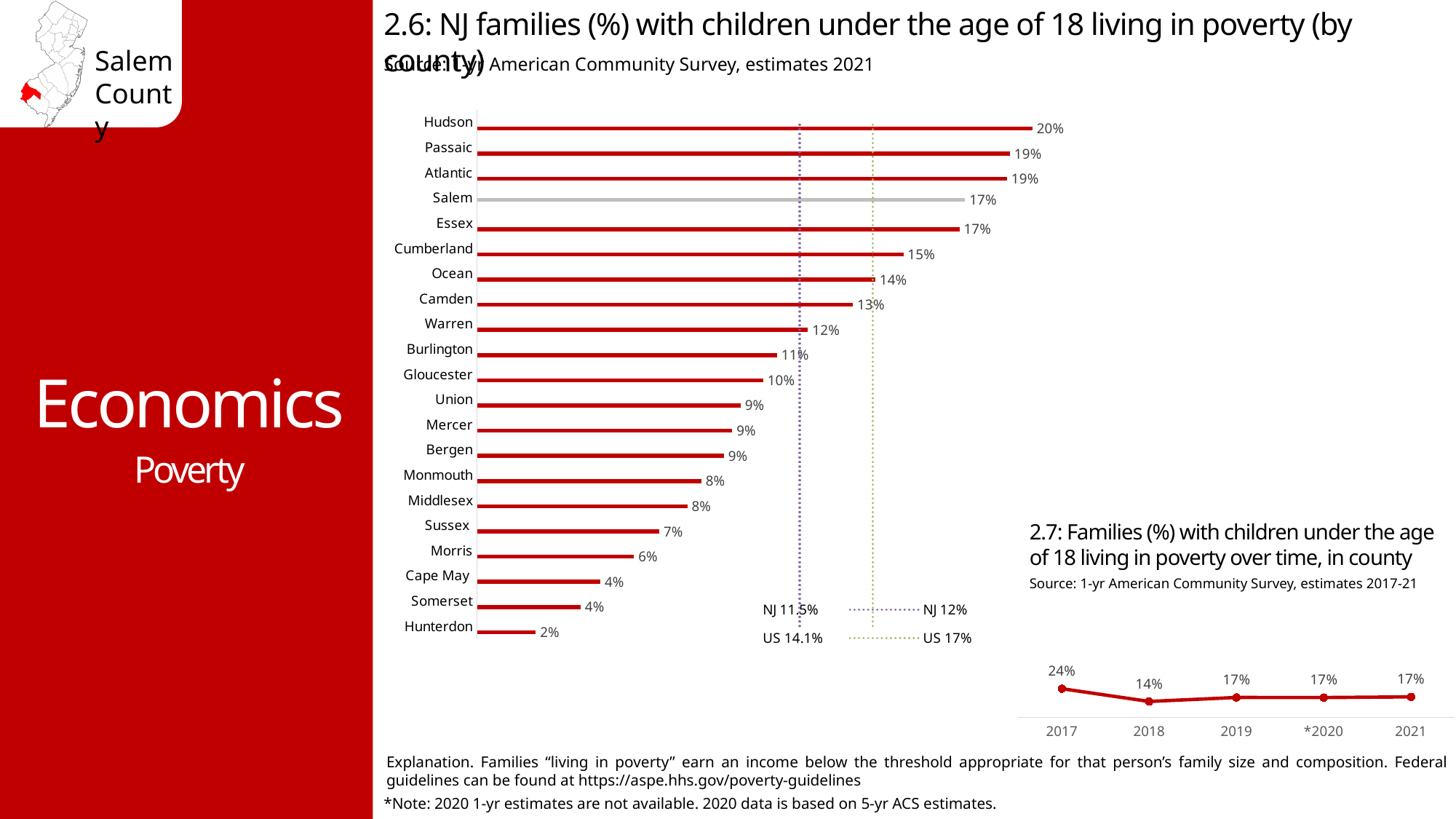
In chart 2.7, what is the value for 2017? 24% In chart 2.7, what is the difference between the values for 2017 and 2018? 10% What kind of chart is chart 2.6? Bar chart In chart 2.6, which county has the lowest value? Hunterdon In chart 2.6, which is larger, the value for Camden or the value for Gloucester? Camden In chart 2.6, what is the value for Salem? 17% In chart 2.6, which county has the highest value? Hudson In chart 2.7, which year has the lowest value? 2018 In chart 2.6, what is the difference between the values for Hudson and Hunterdon? 18% In chart 2.6, what is the value for Cumberland? 15% In chart 2.6, how many counties are shown? 21 In chart 2.6, which bar is shown in grey rather than red? Salem